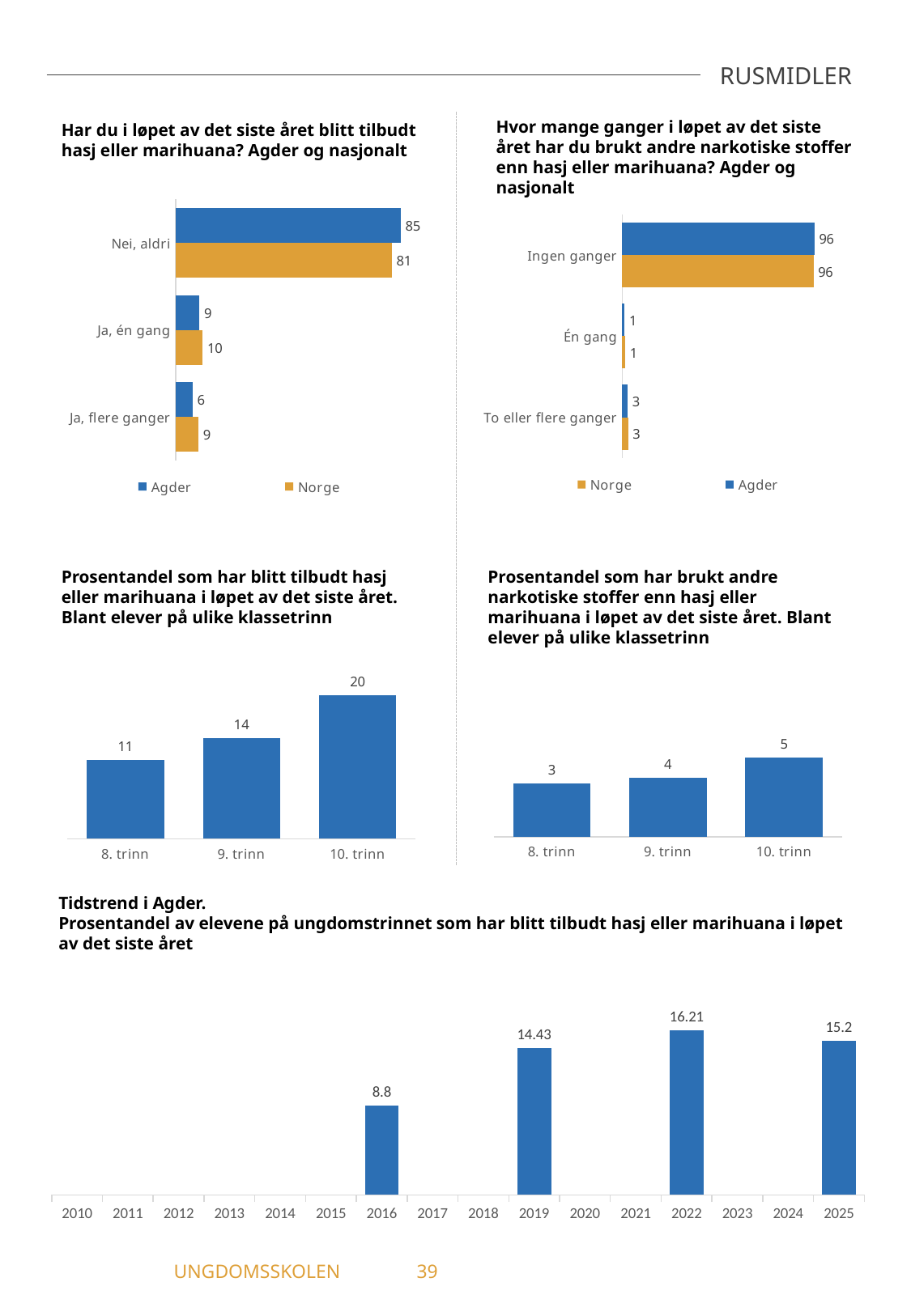
In the top-left chart 'Har du i løpet av det siste året blitt tilbudt hasj eller marihuana?', which is larger for 'Ja, én gang': Agder or Norge? Norge In the chart 'Prosentandel som har blitt tilbudt hasj eller marihuana i løpet av det siste året. Blant elever på ulike klassetrinn', which grade has the highest value? 10. trinn In the bottom chart 'Tidstrend i Agder', what is the value for 2022? 16.21 How many series does the legend list in the top-right chart 'Hvor mange ganger i løpet av det siste året har du brukt andre narkotiske stoffer enn hasj eller marihuana?'? 2 In the chart 'Prosentandel som har blitt tilbudt hasj eller marihuana i løpet av det siste året. Blant elever på ulike klassetrinn', what is the difference between 10. trinn and 8. trinn? 9 In the top-left chart 'Har du i løpet av det siste året blitt tilbudt hasj eller marihuana?', what is the difference between the Norge and Agder values for 'Ja, flere ganger'? 3 In the chart 'Prosentandel som har brukt andre narkotiske stoffer enn hasj eller marihuana i løpet av det siste året. Blant elever på ulike klassetrinn', what is the value for 9. trinn? 4 In the top-left chart 'Har du i løpet av det siste året blitt tilbudt hasj eller marihuana?', what is the value for Agder for 'Nei, aldri'? 85 In the top-right chart 'Hvor mange ganger i løpet av det siste året har du brukt andre narkotiske stoffer enn hasj eller marihuana?', what is the value for Agder for 'To eller flere ganger'? 3 In the bottom chart 'Tidstrend i Agder', which year has the lowest value? 2016 In the top-right chart 'Hvor mange ganger i løpet av det siste året har du brukt andre narkotiske stoffer enn hasj eller marihuana?', what is the value for Norge for 'Ingen ganger'? 96 In the chart 'Prosentandel som har brukt andre narkotiske stoffer enn hasj eller marihuana i løpet av det siste året. Blant elever på ulike klassetrinn', do the values rise or fall from 8. trinn to 10. trinn? rise